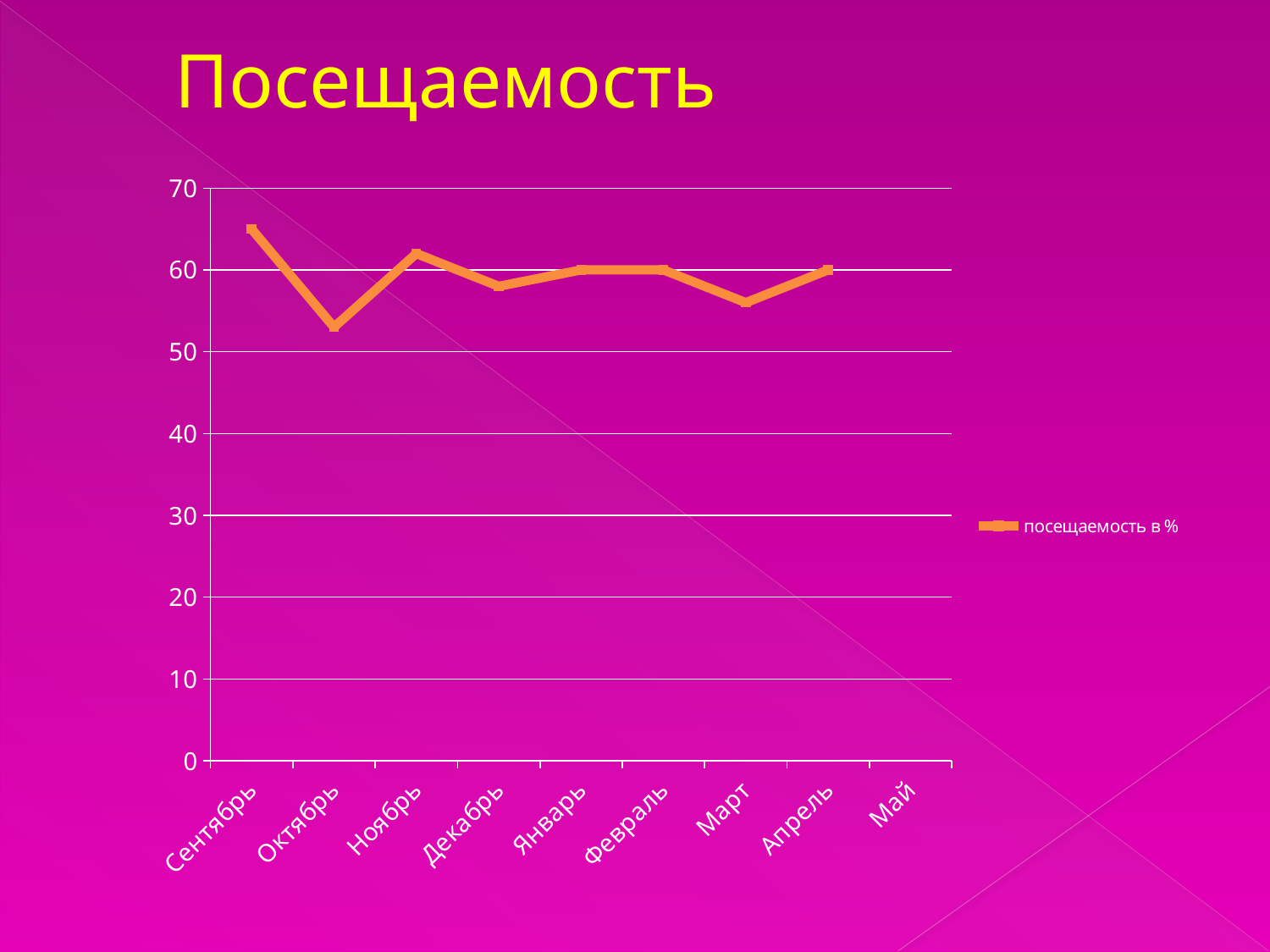
Is the value for Март greater or less than 60? less Which is larger, the value for Ноябрь or the value for Март? Ноябрь Is the value for Сентябрь greater or less than 60? greater Which month has the highest value? Сентябрь What is the title of the chart? Посещаемость Which month has the lowest value? Октябрь Is the value for Октябрь greater or less than 60? less How many month labels are shown on the x axis? 9 Does the value rise or fall from Сентябрь to Октябрь? fall What kind of chart is shown on the slide? line chart How many series does the legend list? 1 What series name does the legend show? посещаемость в %